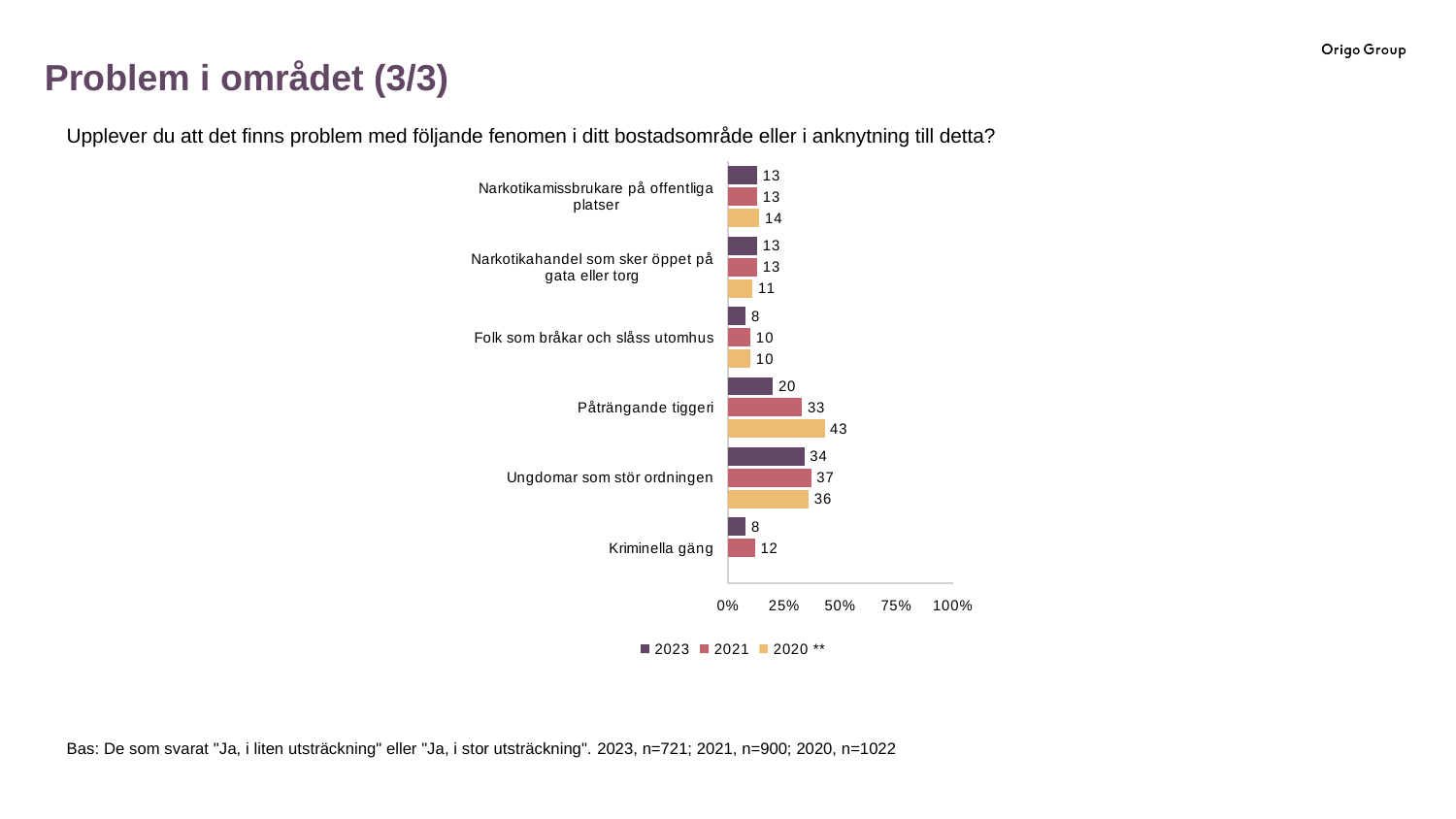
What is the 2023 value for "Påträngande tiggeri"? 20 What is the 2020 ** value for "Narkotikamissbrukare på offentliga platser"? 14 How many series does the legend list? 3 Is the 2021 value for "Påträngande tiggeri" greater or less than 25%? greater Which category has the lowest 2020 ** value? Folk som bråkar och slåss utomhus Which category has no 2020 ** bar? Kriminella gäng What is the difference between the 2020 ** and 2023 values for "Påträngande tiggeri"? 23 For "Ungdomar som stör ordningen", which is larger: the 2021 value or the 2023 value? 2021 Which category has the highest 2023 value? Ungdomar som stör ordningen What kind of chart is shown on the slide? Bar chart What is the 2021 value for "Kriminella gäng"? 12 How many categories are shown on the chart? 6